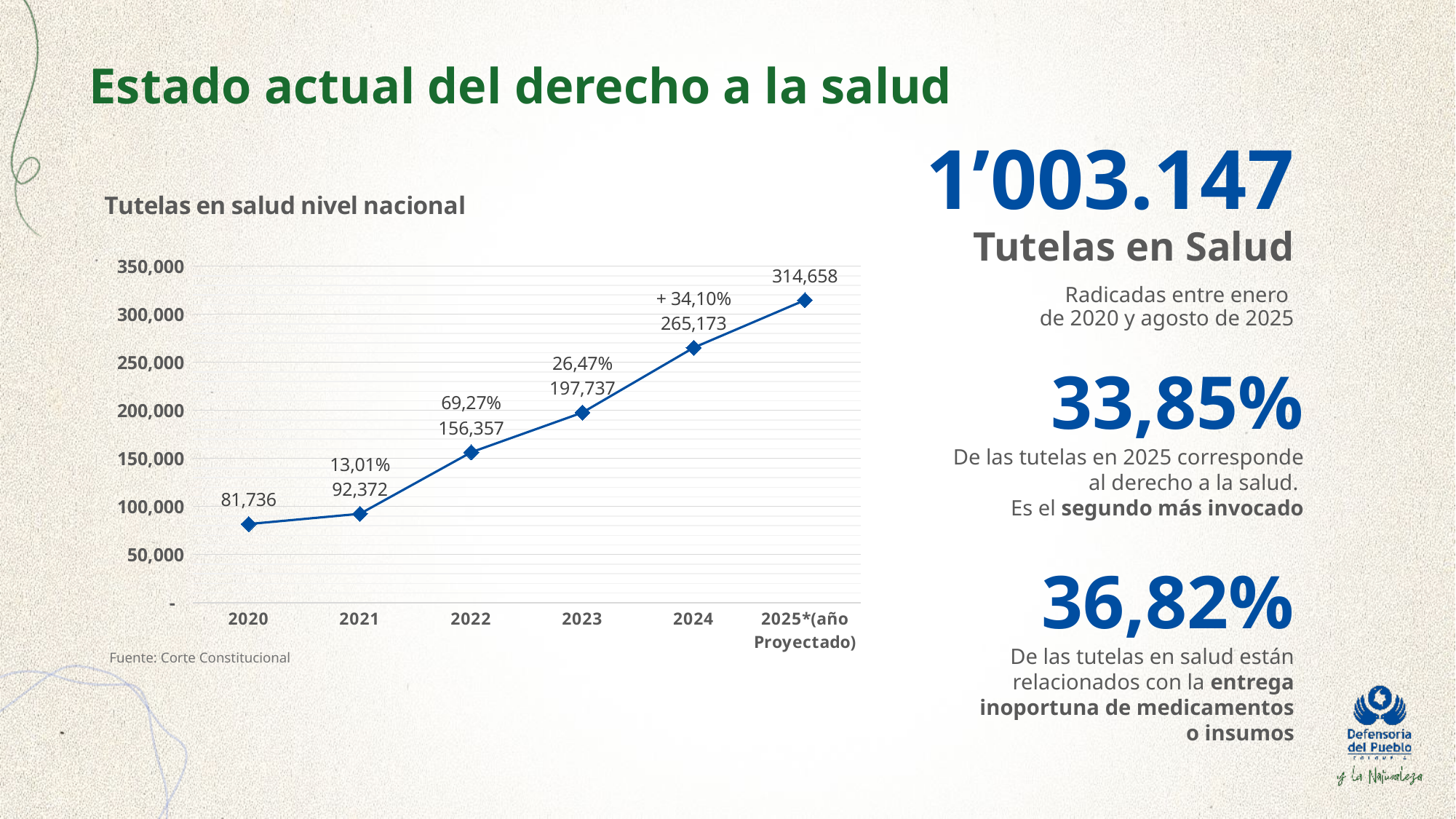
What is the difference between the 2024 and 2023 values in the 'Tutelas en salud nivel nacional' chart? 67,436 What is the value for 2022 in the 'Tutelas en salud nivel nacional' chart? 156,357 Is the value for 2024 in the 'Tutelas en salud nivel nacional' chart greater or less than 250,000? greater How many data points are plotted in the 'Tutelas en salud nivel nacional' chart? 6 What is the value for 2020 in the 'Tutelas en salud nivel nacional' chart? 81,736 What percentage change is labelled above the 2022 point in the 'Tutelas en salud nivel nacional' chart? 69,27% Do the values in the 'Tutelas en salud nivel nacional' chart rise or fall from 2020 to 2025? Rise Which year has the lowest value in the 'Tutelas en salud nivel nacional' chart? 2020 Which is larger in the 'Tutelas en salud nivel nacional' chart, the value for 2021 or the value for 2023? 2023 What kind of chart is 'Tutelas en salud nivel nacional'? Line chart What is the projected value for 2025 in the 'Tutelas en salud nivel nacional' chart? 314,658 Which year has the highest value in the 'Tutelas en salud nivel nacional' chart? 2025*(año Proyectado)